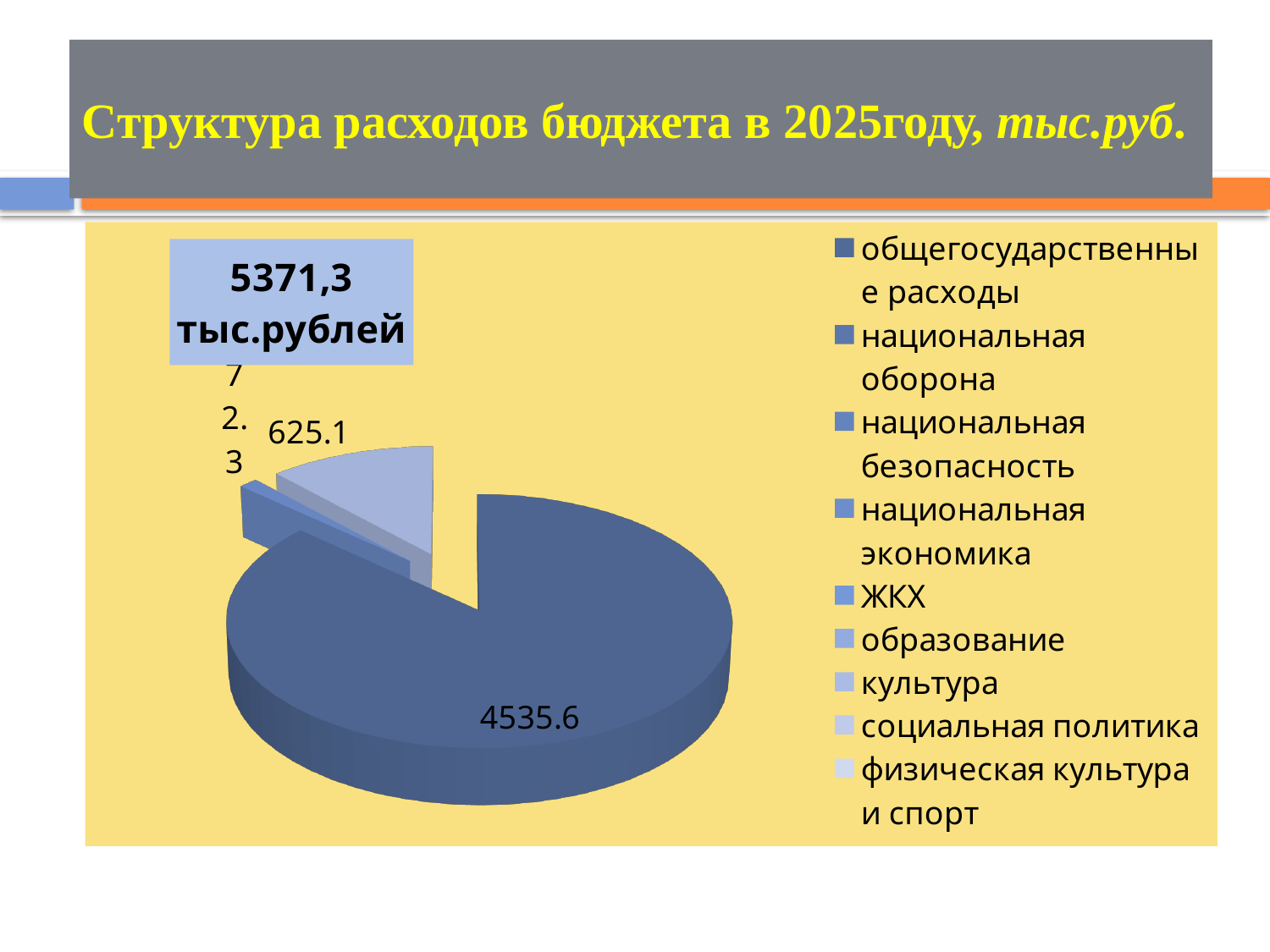
Which category has the largest slice in the pie chart? общегосударственные расходы What total amount is shown in the text box on the chart? 5371,3 тыс.рублей What kind of chart is shown on the slide? pie chart What is the last entry in the chart's legend? физическая культура и спорт Is the value of the slice labelled 625.1 greater or less than 1000? less Which is larger, the slice labelled 4535.6 or the slice labelled 625.1? 4535.6 What is the difference between the slice labelled 4535.6 and the slice labelled 625.1? 3910.5 How many entries does the chart's legend list? 9 What is the value printed on the largest slice of the pie chart? 4535.6 What is the title of the chart on the slide? 5371,3 тыс.рублей Is the value of the largest slice greater or less than 4000? greater